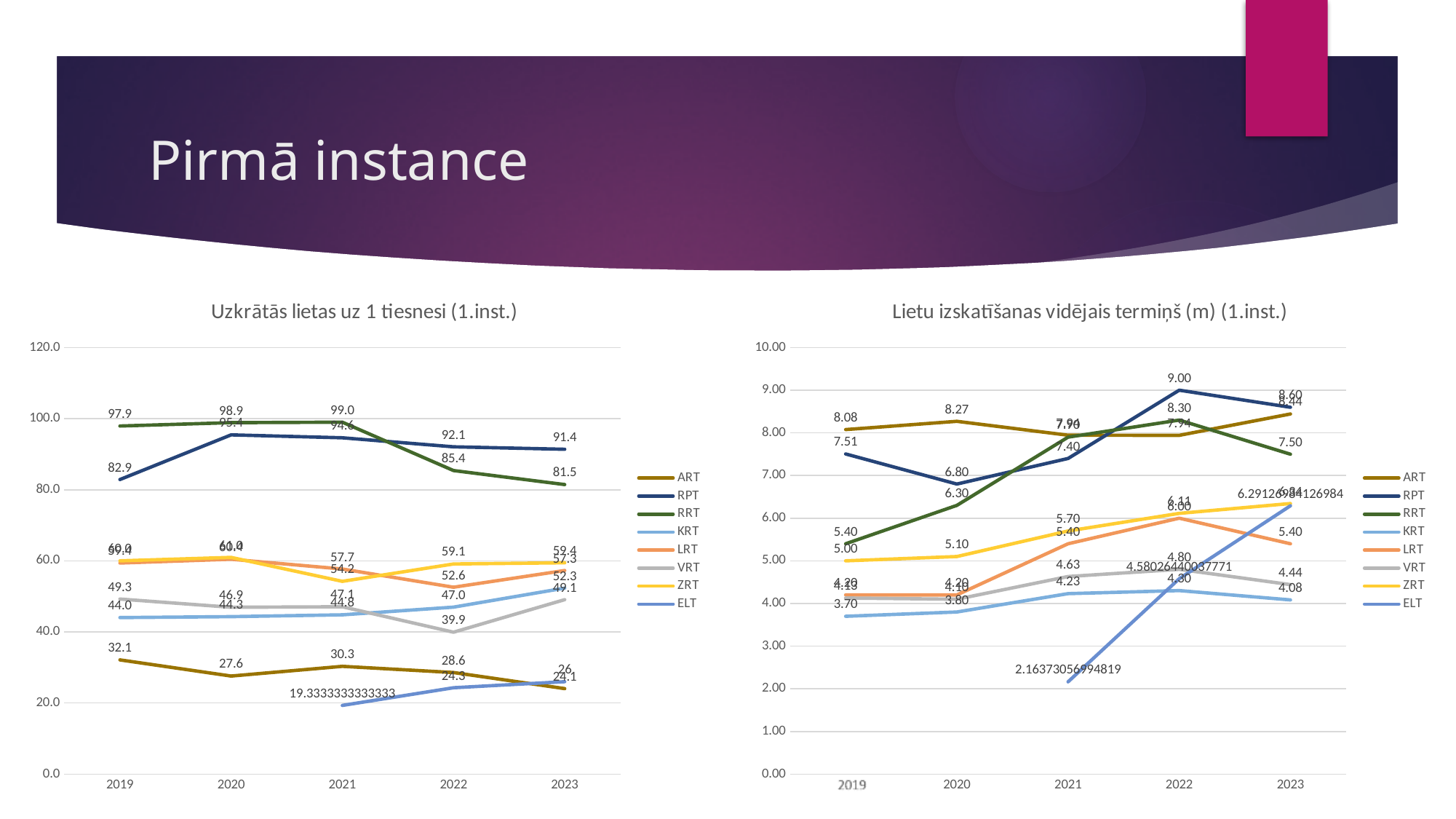
In "Uzkrātās lietas uz 1 tiesnesi (1.inst.)", what is the value for ELT in 2021? 19.3333333333333 In "Uzkrātās lietas uz 1 tiesnesi (1.inst.)", what is the value for RRT in 2019? 97.9 In "Uzkrātās lietas uz 1 tiesnesi (1.inst.)", which is larger in 2023, RPT or RRT? RPT In "Lietu izskatīšanas vidējais termiņš (m) (1.inst.)", which series has the highest value in 2022? RPT In "Uzkrātās lietas uz 1 tiesnesi (1.inst.)", what is the difference between the RRT values for 2019 and 2023? 16.4 How many years are shown on the x axis of "Uzkrātās lietas uz 1 tiesnesi (1.inst.)"? 5 In "Uzkrātās lietas uz 1 tiesnesi (1.inst.)", what is the value for RPT in 2019? 82.9 In "Uzkrātās lietas uz 1 tiesnesi (1.inst.)", does the RRT line rise or fall from 2021 to 2023? fall How many series does the legend of "Lietu izskatīšanas vidējais termiņš (m) (1.inst.)" list? 8 What kind of chart is "Uzkrātās lietas uz 1 tiesnesi (1.inst.)"? line chart In "Lietu izskatīšanas vidējais termiņš (m) (1.inst.)", what is the value for RPT in 2022? 9.00 In "Lietu izskatīšanas vidējais termiņš (m) (1.inst.)", what is the value for ELT in 2021? 2.16373056994819